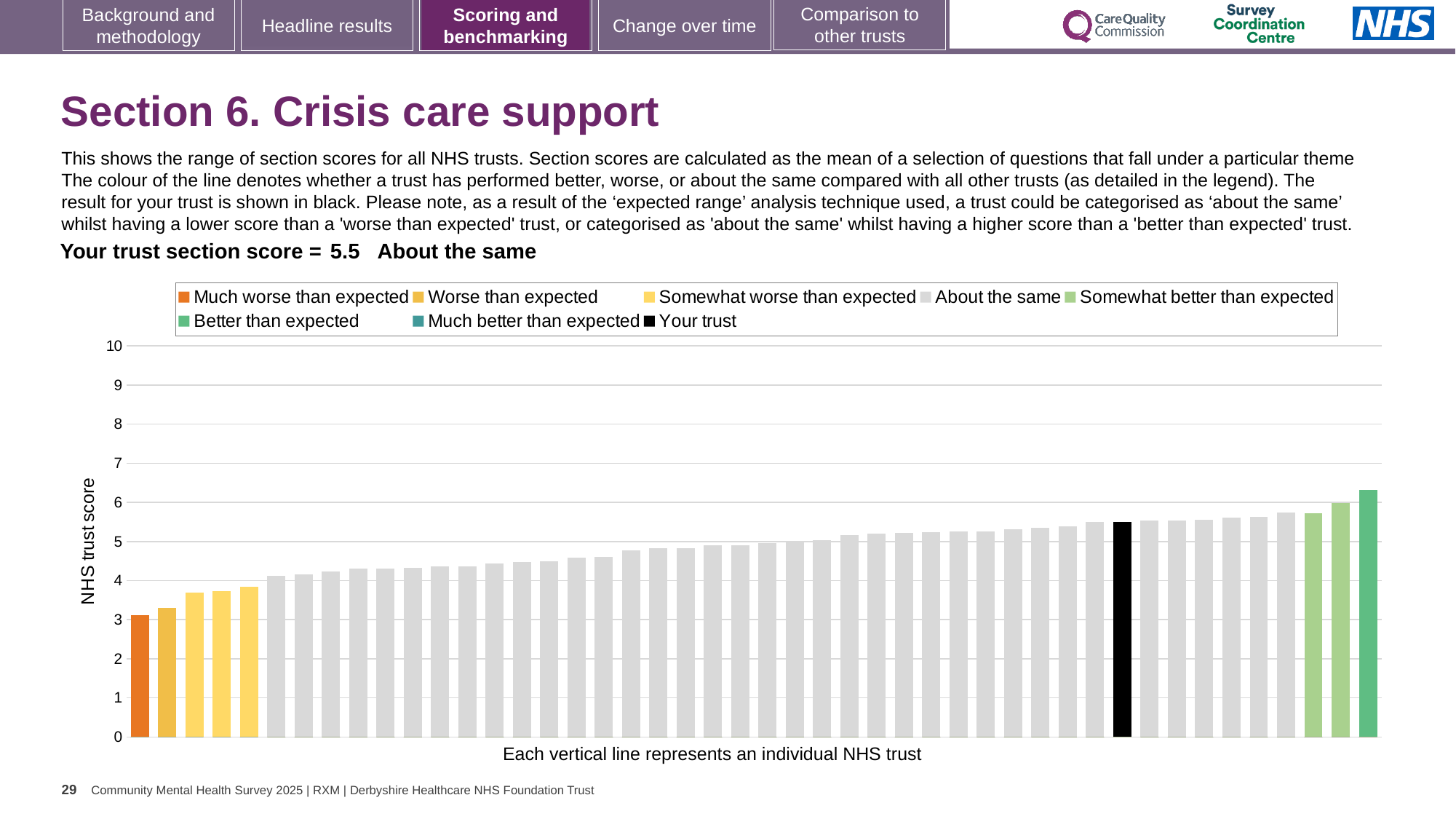
How many entries does the chart legend list? 8 Which category is your trust's section score placed in? About the same Is the value of the highest bar (the 'Better than expected' trust) greater or less than 6? greater Do the bar values rise or fall from left to right along the x axis? rise Is the value of the lowest bar (the 'Much worse than expected' trust) greater or less than 4? less Which is larger: the score of your trust (black bar) or the score of the 'Better than expected' trust (rightmost bar)? Better than expected trust What is the section score for your trust shown on the slide? 5.5 How many bars are coloured as 'Somewhat better than expected'? 2 What kind of chart is shown on the slide? bar chart Is your trust's section score greater or less than 5? greater What is the label of the vertical axis? NHS trust score How many bars are coloured as 'Much worse than expected'? 1